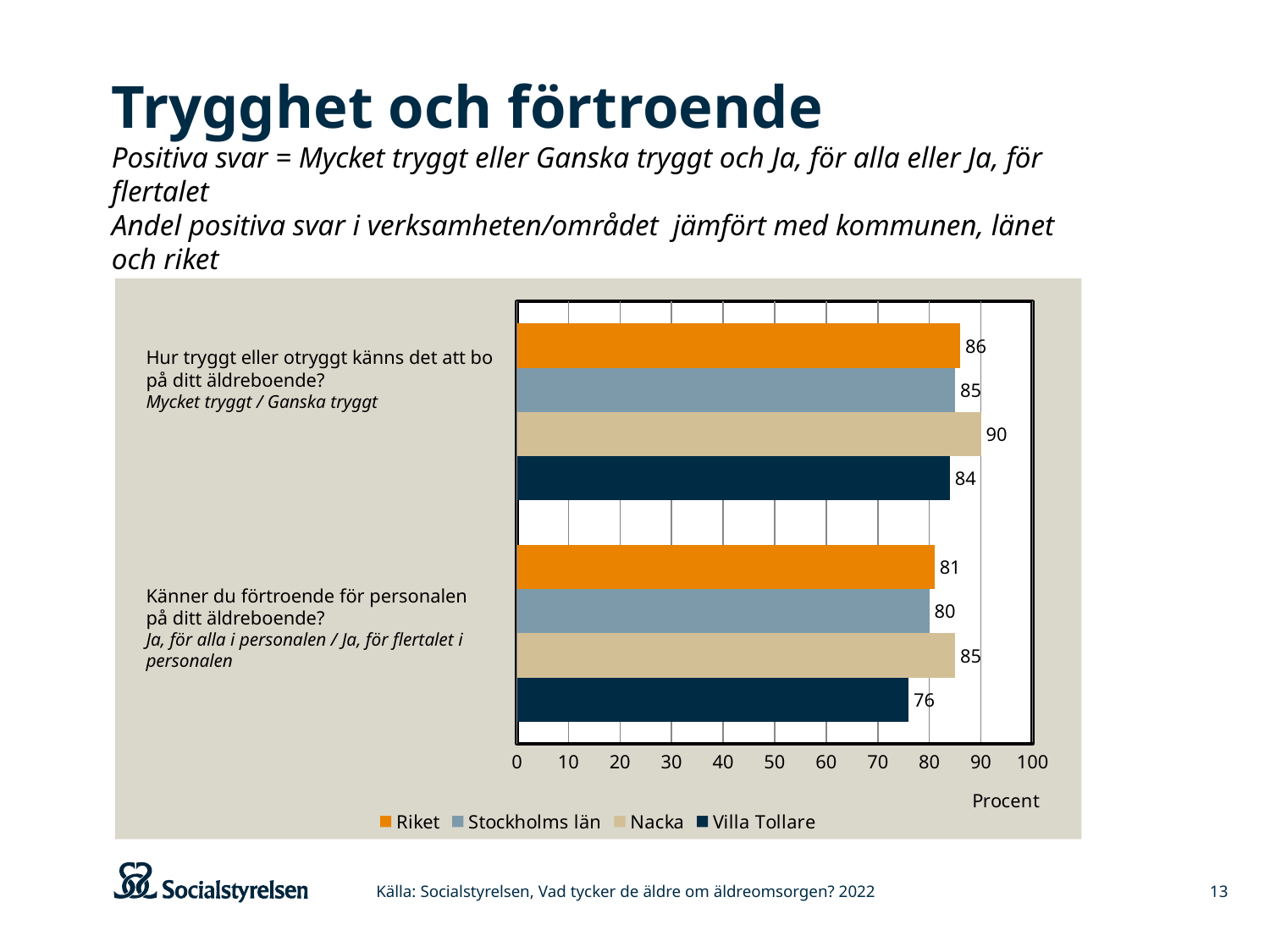
What is the label on the horizontal axis of the chart? Procent How many series does the legend list? 4 Which series has the highest value on the question "Känner du förtroende för personalen på ditt äldreboende?"? Nacka What is the value for Nacka on the question "Hur tryggt eller otryggt känns det att bo på ditt äldreboende?"? 90 Which is larger: the Riket value or the Villa Tollare value on the question "Hur tryggt eller otryggt känns det att bo på ditt äldreboende?"? Riket Which series has the lowest value on the question "Hur tryggt eller otryggt känns det att bo på ditt äldreboende?"? Villa Tollare What is the difference between the Nacka and Villa Tollare values on the question "Känner du förtroende för personalen på ditt äldreboende?"? 9 What is the value for Riket on the question "Känner du förtroende för personalen på ditt äldreboende?"? 81 What is the value for Villa Tollare on the question "Känner du förtroende för personalen på ditt äldreboende?"? 76 What is the value for Stockholms län on the question "Hur tryggt eller otryggt känns det att bo på ditt äldreboende?"? 85 What kind of chart is shown on the slide? Bar chart Is the value for Villa Tollare on the question "Känner du förtroende för personalen på ditt äldreboende?" greater or less than 80? less